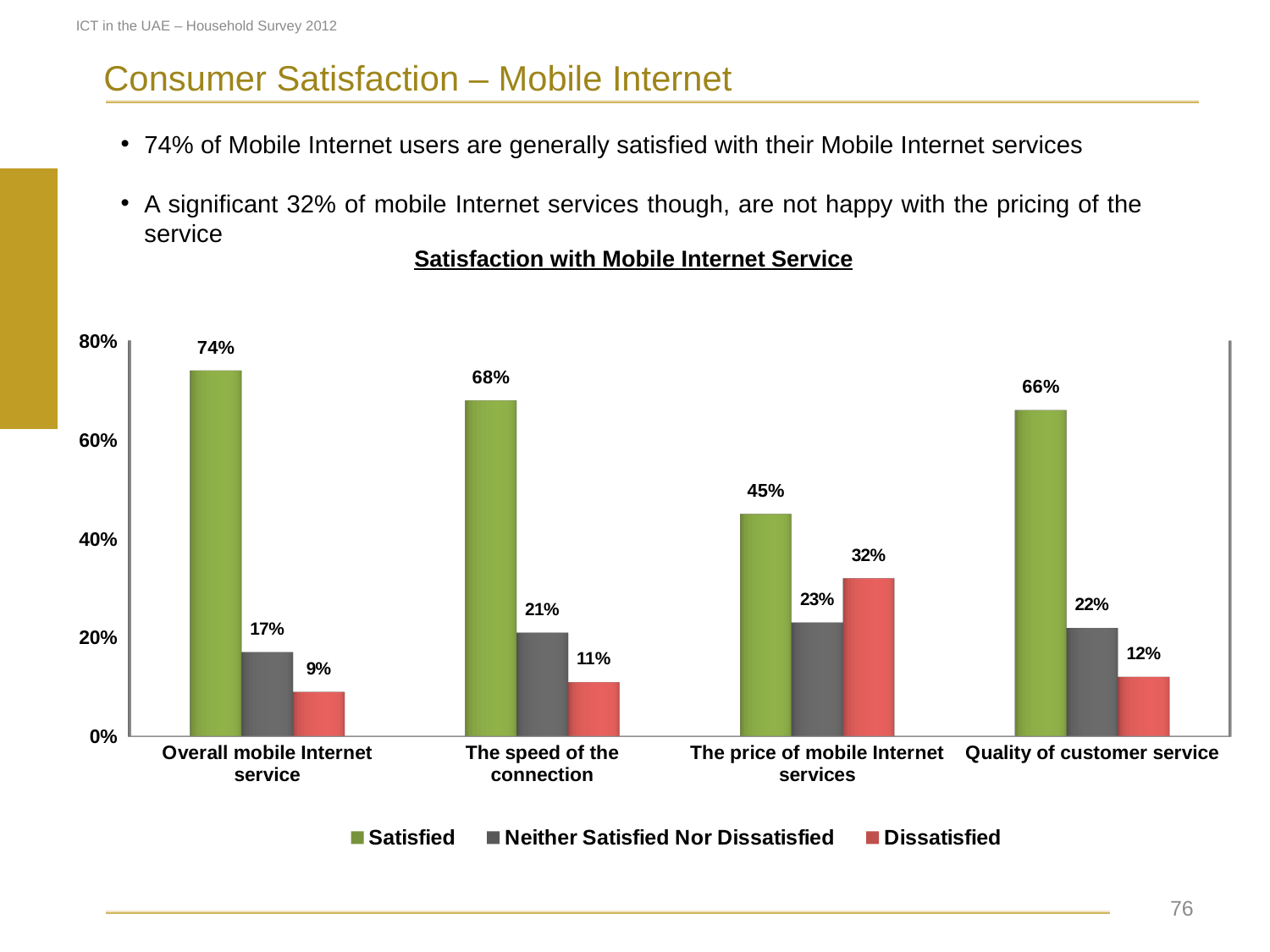
Is the Satisfied value for the price of mobile Internet services greater or less than 60%? less How many series does the legend list? 3 What is the difference between the Satisfied values for overall mobile Internet service and quality of customer service? 8% Which category has the highest Dissatisfied value? The price of mobile Internet services How many categories are shown on the x axis? 4 What percentage of users are satisfied with the overall mobile Internet service? 74% Which category has the lowest Satisfied value? The price of mobile Internet services Is the Satisfied value for the speed of the connection larger than the Satisfied value for quality of customer service? Yes What is the Dissatisfied value for the price of mobile Internet services? 32% What is the Neither Satisfied Nor Dissatisfied value for the speed of the connection? 21% What is the title of the chart? Satisfaction with Mobile Internet Service What kind of chart is shown on the slide? Bar chart